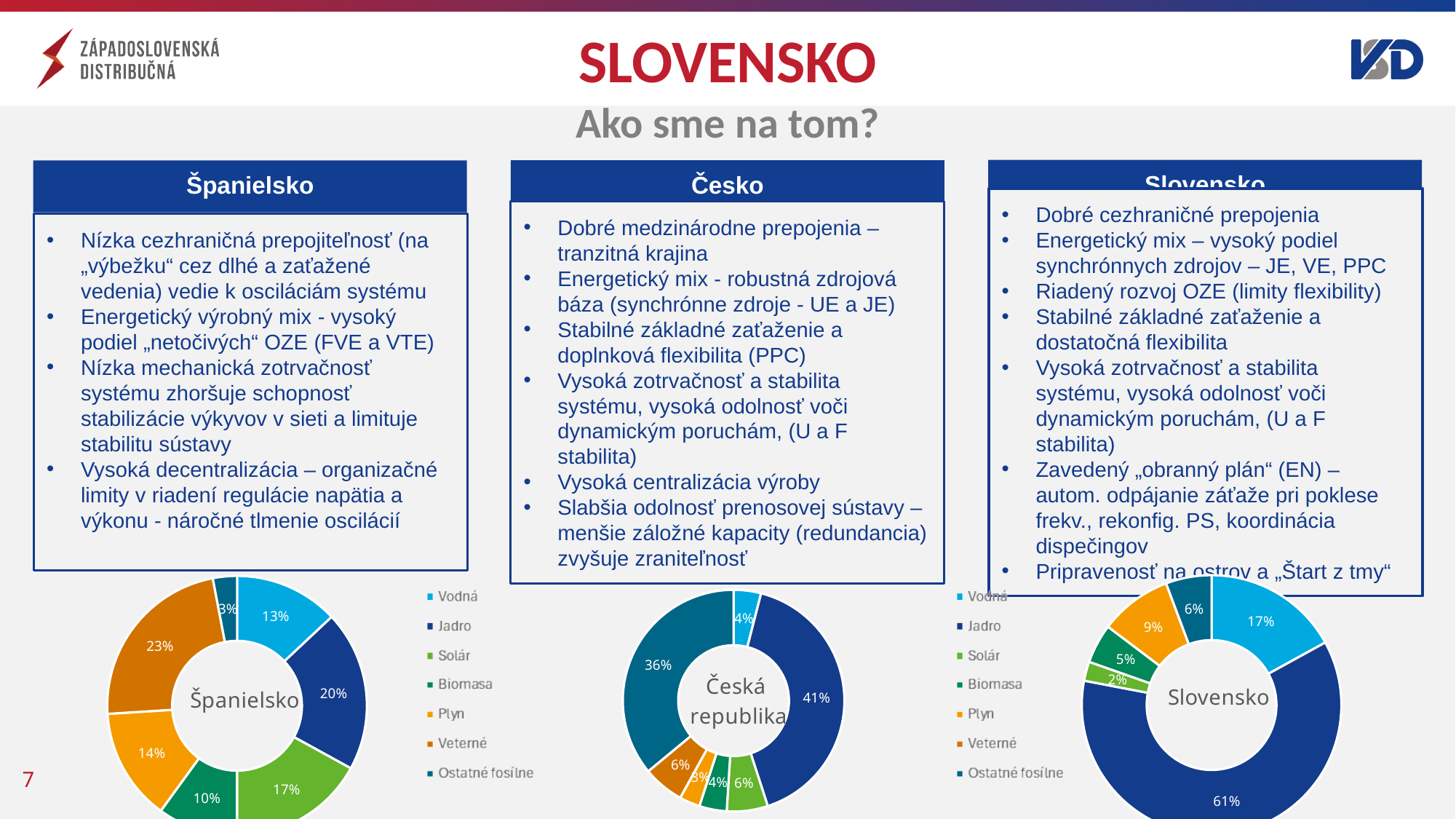
In the Španielsko chart, which is larger, the share for Solár or the share for Plyn? Solár In the Česká republika chart, which category has the smallest share? Plyn In the Španielsko chart, which category has the smallest share? Ostatné fosílne How many entries does the legend next to the Španielsko chart list? 7 In the Slovensko chart, what share does Vodná have? 17% In the Česká republika chart, what is the difference between the Jadro share and the Ostatné fosílne share? 5% In the Španielsko chart, what share does Veterné have? 23% In the Česká republika chart, what share does Jadro have? 41% What kind of chart is used to show the energy mix of Slovensko? Donut (pie) chart In the Slovensko chart, which category has the largest share? Jadro In the Slovensko chart, what is the difference between the Jadro share and the Vodná share? 44% In the Slovensko chart, what share does Plyn have? 9%